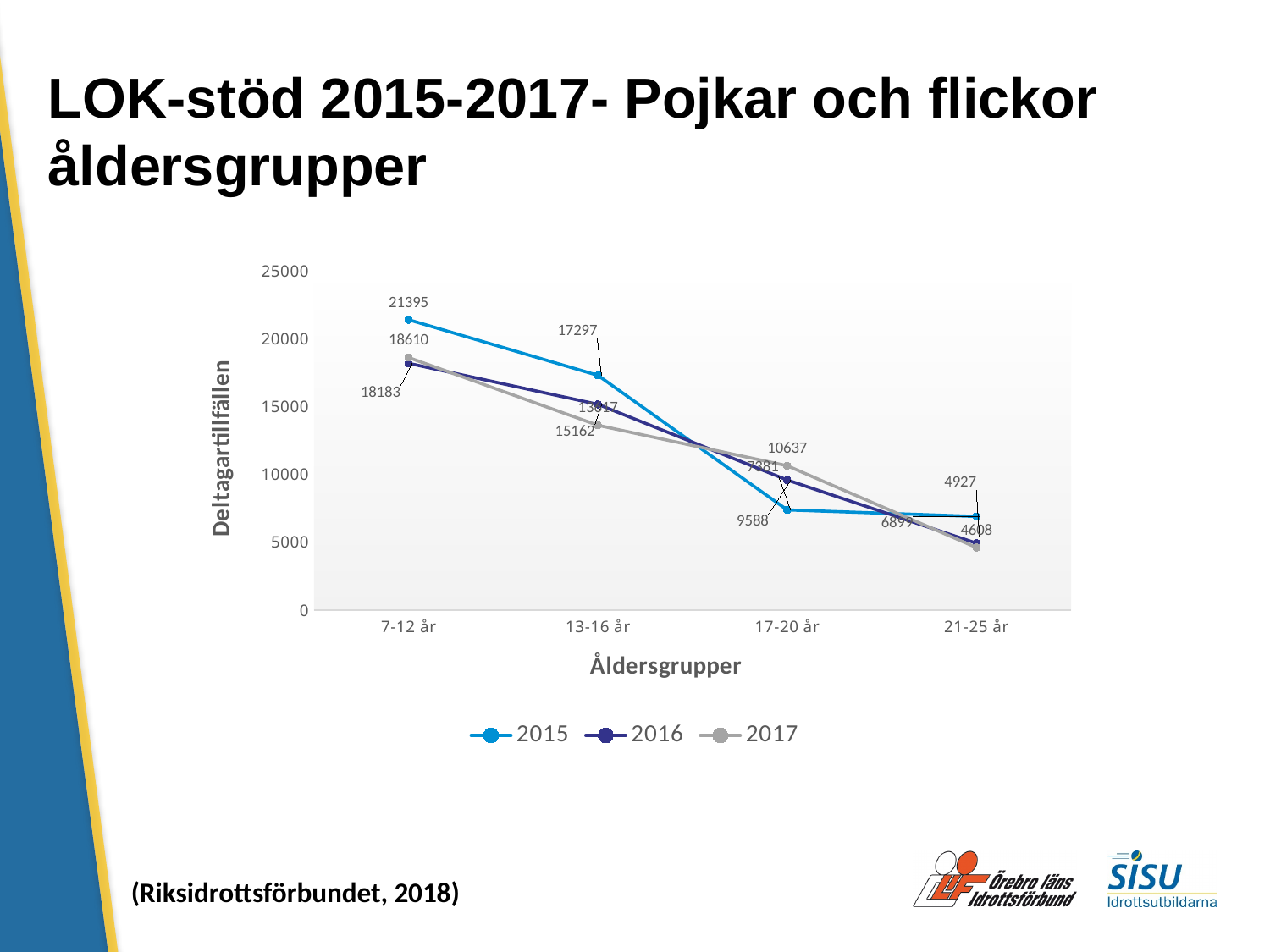
Is the value for 2015 in the 17-20 år age group greater or less than 10000? less Do the values for the 2015 series rise or fall across the age groups from 7-12 år to 21-25 år? fall What kind of chart is shown on the slide? line chart Which series has the highest value in the 7-12 år age group? 2015 How many series does the legend list? 3 What is the difference between the 2015 values for 7-12 år and 13-16 år? 4098 Which age group has the highest value for the 2015 series? 7-12 år Which series has the highest value in the 21-25 år age group? 2015 What is the value for 2015 in the 7-12 år age group? 21395 How many age groups are shown on the x axis? 4 What is the title of the vertical axis? Deltagartillfällen What is the value for 2015 in the 13-16 år age group? 17297